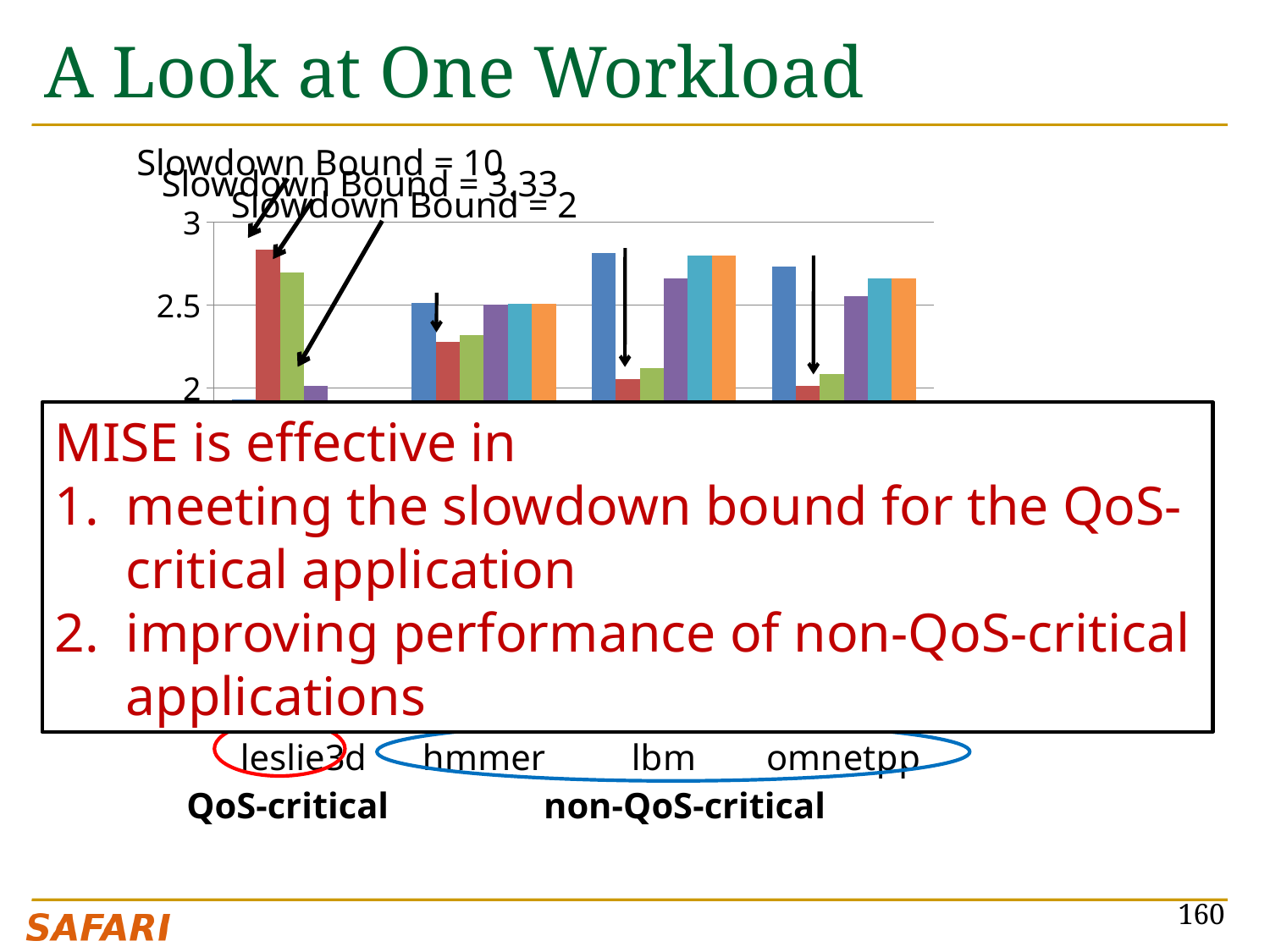
Is the value of the red bar for leslie3d greater or less than 2.5? greater Is the value of the orange bar for lbm greater or less than 2.5? greater For leslie3d, which is taller: the red bar or the green bar? the red bar Is the value of the green bar for omnetpp greater or less than 2.5? less Which application on the x axis is labelled as QoS-critical? leslie3d What three slowdown bound values are annotated above the chart? 10, 3.33, 2 What kind of chart is shown on the slide? bar chart For lbm, which is taller: the blue bar or the red bar? the blue bar How many application categories are shown along the x axis of the chart? 4 For hmmer, which is taller: the blue bar or the red bar? the blue bar